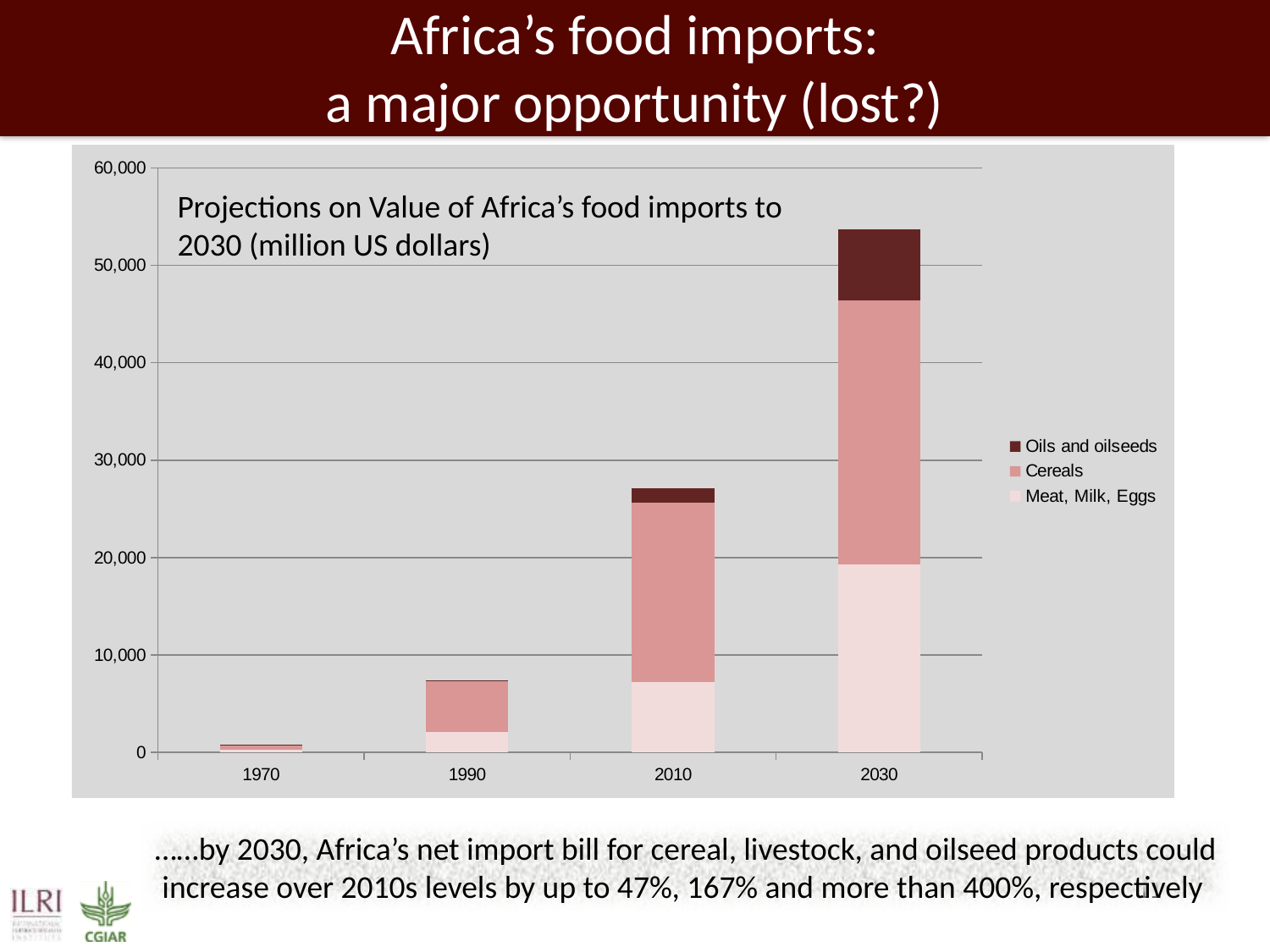
Do the total food import values rise or fall from 1970 to 2030? Rise What kind of chart is shown on the slide? Stacked bar chart Which series is shown in the darkest colour in the chart's legend? Oils and oilseeds How many series does the chart's legend list? 3 Is the total value for 2030 greater or less than 50,000? greater Which year has the larger total value of food imports, 2010 or 2030? 2030 Is the total value for 2010 greater or less than 20,000? greater Which year has the highest total value of food imports? 2030 Which year has the lowest total value of food imports? 1970 How many years are shown on the x axis of the chart? 4 What is the title of the chart? Projections on Value of Africa's food imports to 2030 (million US dollars) Is the total value for 1990 greater or less than 10,000? less